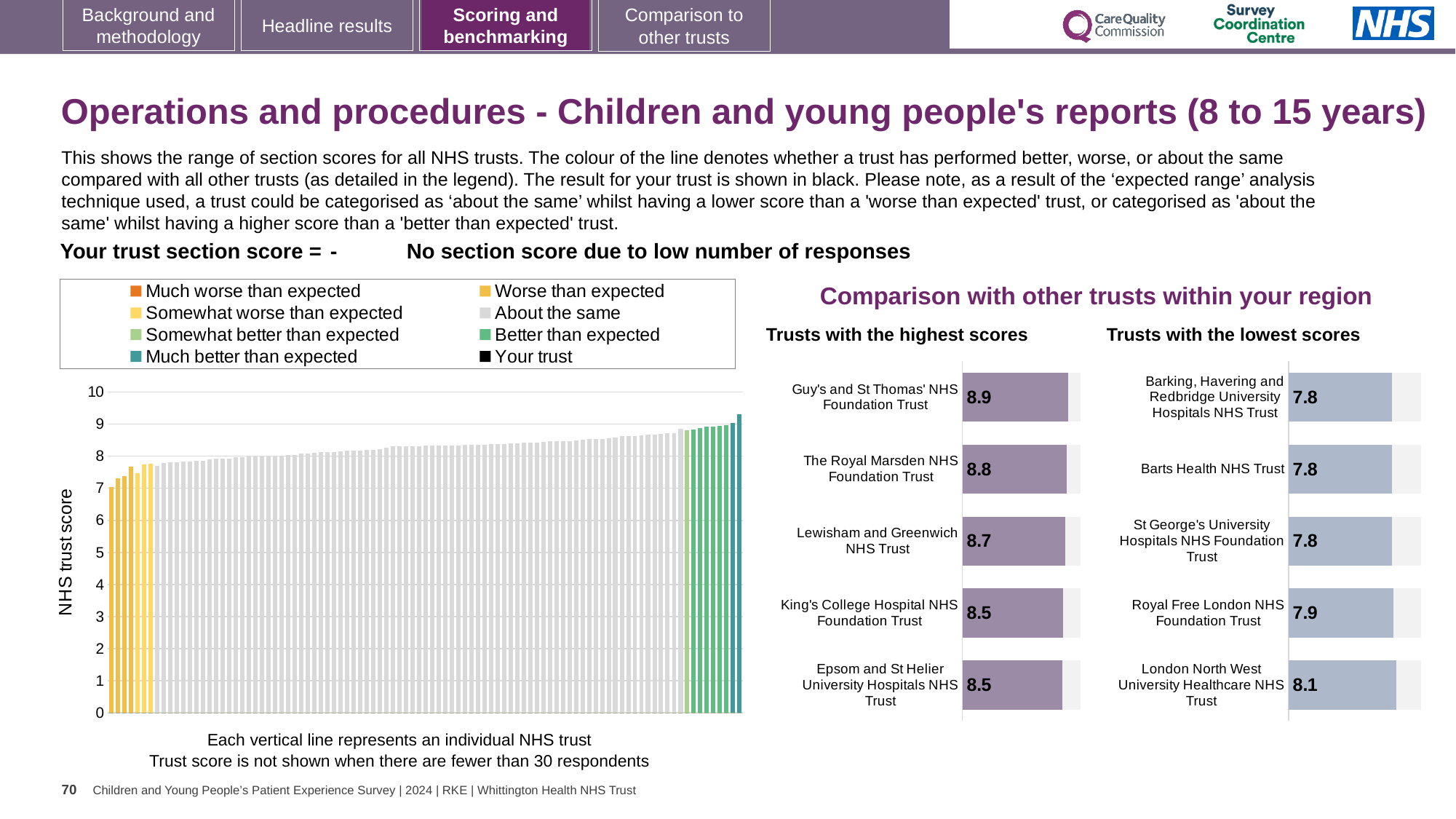
In the 'Trusts with the highest scores' chart, what is the score for Lewisham and Greenwich NHS Trust? 8.7 How many trusts are listed in the 'Trusts with the highest scores' chart? 5 In the 'Trusts with the highest scores' chart, what is the score for Guy's and St Thomas' NHS Foundation Trust? 8.9 How many entries does the legend of the main 'NHS trust score' chart list? 8 In the 'Trusts with the lowest scores' chart, what is the score for Royal Free London NHS Foundation Trust? 7.9 In the main 'NHS trust score' chart on the left, do the values rise or fall from left to right? rise In the 'Trusts with the highest scores' chart, which trust has the highest score? Guy's and St Thomas' NHS Foundation Trust In the 'Trusts with the highest scores' chart, what is the difference between the scores of Guy's and St Thomas' NHS Foundation Trust and The Royal Marsden NHS Foundation Trust? 0.1 In the 'Trusts with the lowest scores' chart, what is the score for London North West University Healthcare NHS Trust? 8.1 In the 'Trusts with the lowest scores' chart, which trust has the highest score? London North West University Healthcare NHS Trust In the 'Trusts with the lowest scores' chart, what is the difference between the scores of London North West University Healthcare NHS Trust and Barts Health NHS Trust? 0.3 Which is larger: the score for The Royal Marsden NHS Foundation Trust in the highest scores chart or the score for Royal Free London NHS Foundation Trust in the lowest scores chart? The Royal Marsden NHS Foundation Trust